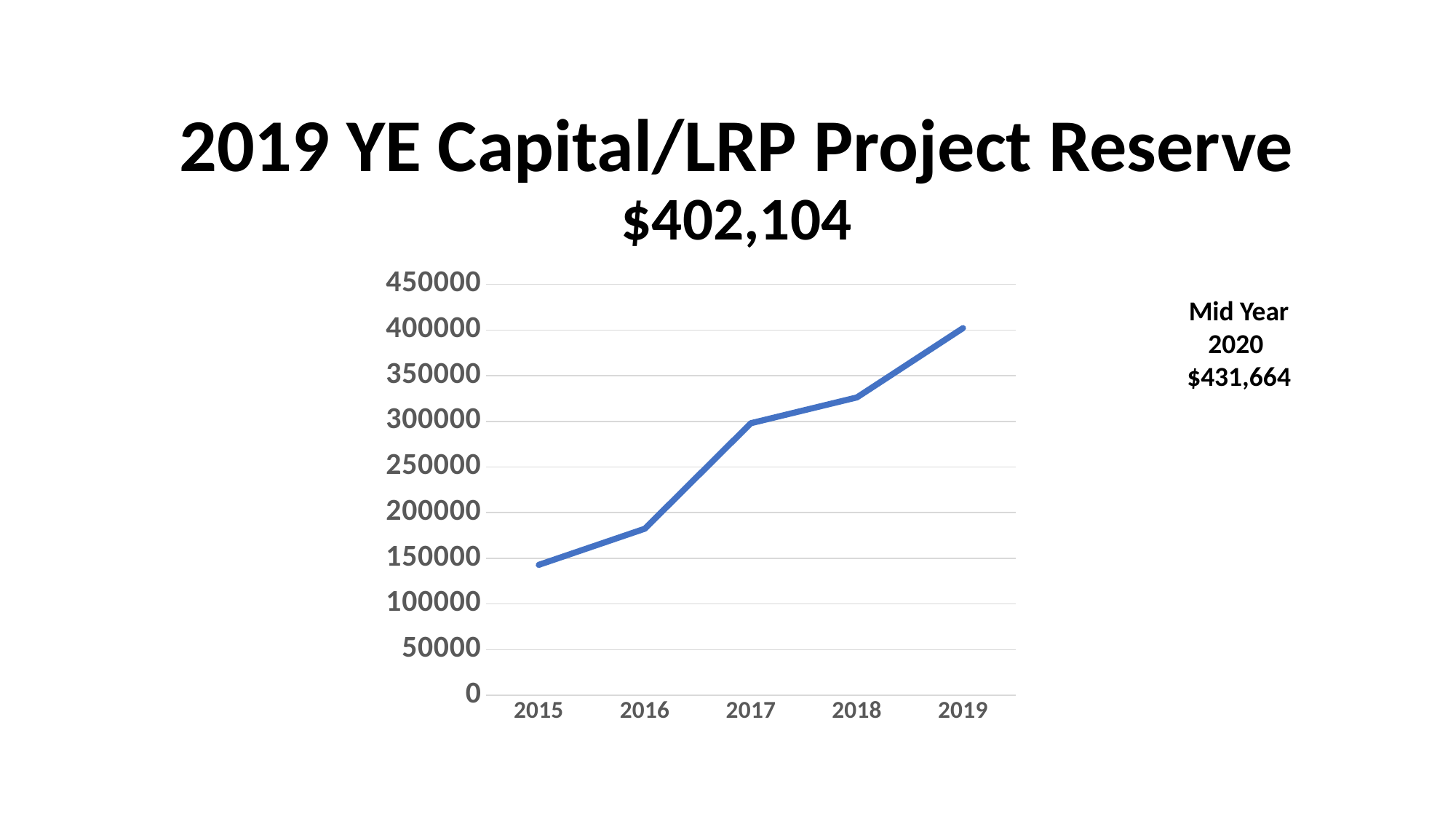
Which year has the lowest value on the chart? 2015 How many years are plotted along the x axis of the chart? 5 Which year has the highest value on the chart? 2019 What kind of chart is shown on the slide? line chart Which is larger, the value for 2016 or the value for 2018? 2018 Do the values rise or fall from 2015 to 2019? rise Is the value for 2015 greater or less than 150000? less What Mid Year 2020 amount is noted beside the chart? $431,664 Is the value for 2018 greater or less than 300000? greater Is the value for 2016 greater or less than 200000? less What is the 2019 year-end Capital/LRP Project Reserve amount stated on the slide? $402,104